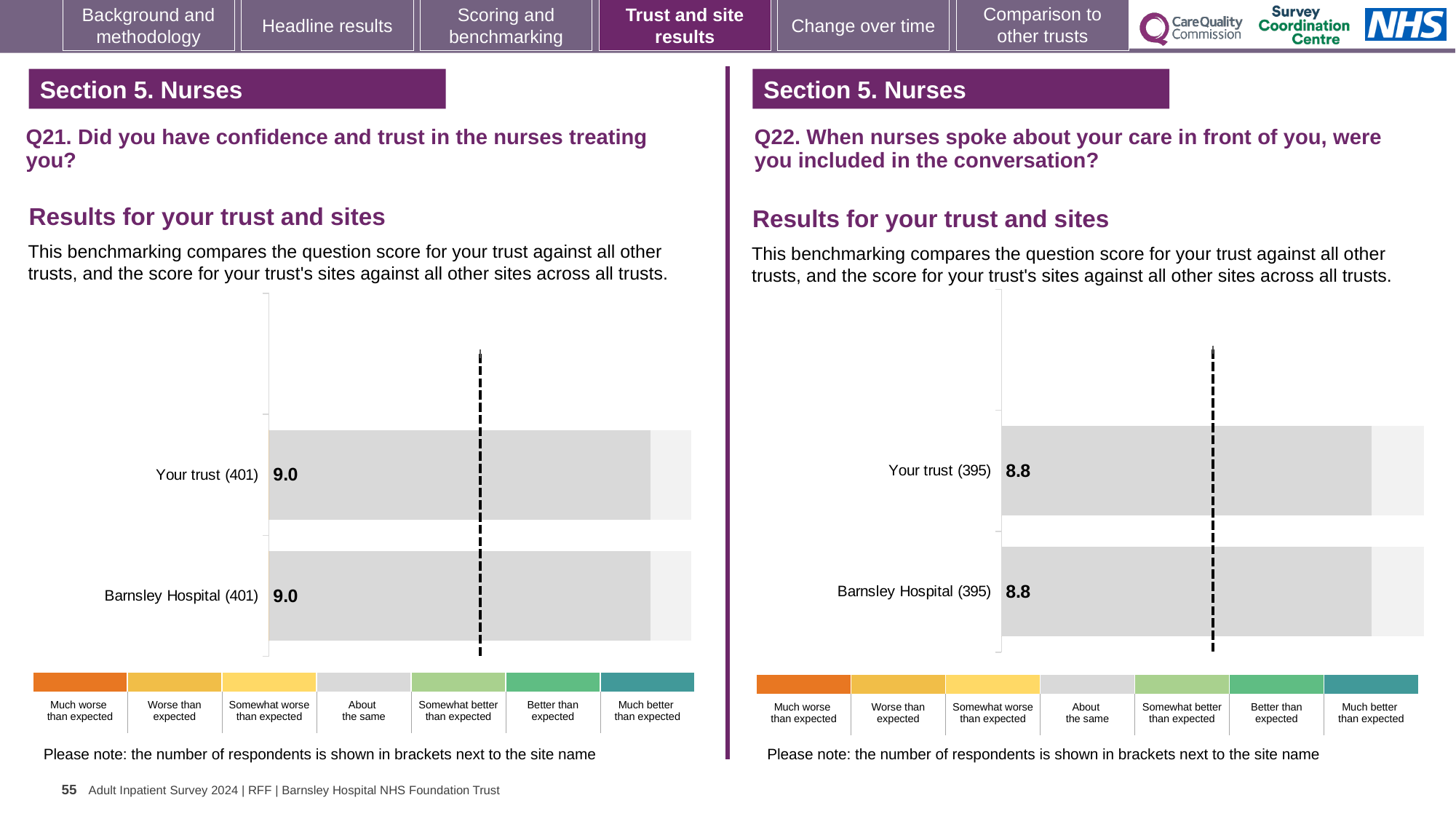
What is the difference between the Barnsley Hospital score on the Q21 chart (left) and the Barnsley Hospital score on the Q22 chart (right)? 0.2 On the Q22 chart (right), is the score for Your trust the same as the score for Barnsley Hospital? Yes On the Q22 chart (right), how many bars are plotted? 2 On the Q22 chart (right), what is the score for Barnsley Hospital? 8.8 On the Q22 chart (right), what is the score for Your trust? 8.8 On the Q21 chart (left), how many bars are plotted? 2 On the Q21 chart (left), what is the score for Your trust? 9.0 Which is larger: the Your trust score on the Q21 chart (left) or the Your trust score on the Q22 chart (right)? Q21 chart (left) On the Q22 chart (right), how many respondents are shown in brackets next to Barnsley Hospital? 395 What kind of chart is the Q21 chart (left)? bar chart On the Q21 chart (left), how many respondents are shown in brackets next to Your trust? 401 On the Q21 chart (left), what is the score for Barnsley Hospital? 9.0